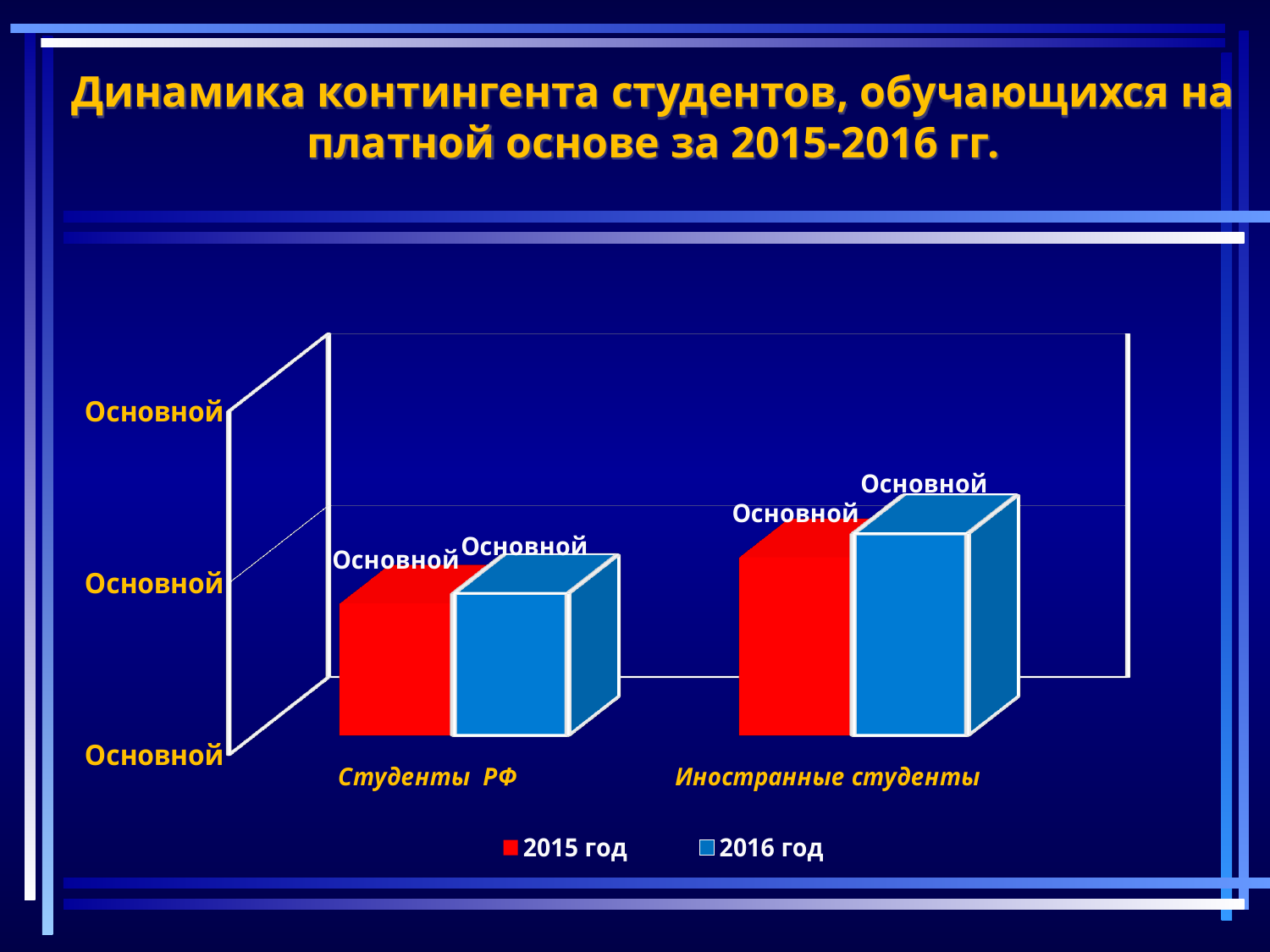
Which category has the highest values in the chart? Иностранные студенты What are the two series listed in the chart's legend? 2015 год and 2016 год How many series does the chart's legend list? 2 What are the two category labels on the x axis of the chart? Студенты РФ and Иностранные студенты How many categories are shown on the x axis of the chart? 2 Which category has the lowest values in the chart? Студенты РФ For the 2016 год series, which category has the larger value: Студенты РФ or Иностранные студенты? Иностранные студенты What is the title of the chart on the slide? Динамика контингента студентов, обучающихся на платной основе за 2015-2016 гг. What kind of chart is shown on the slide? bar chart Which category has the taller bars in the chart, Студенты РФ or Иностранные студенты? Иностранные студенты For the 2015 год series, which category has the larger value: Студенты РФ or Иностранные студенты? Иностранные студенты